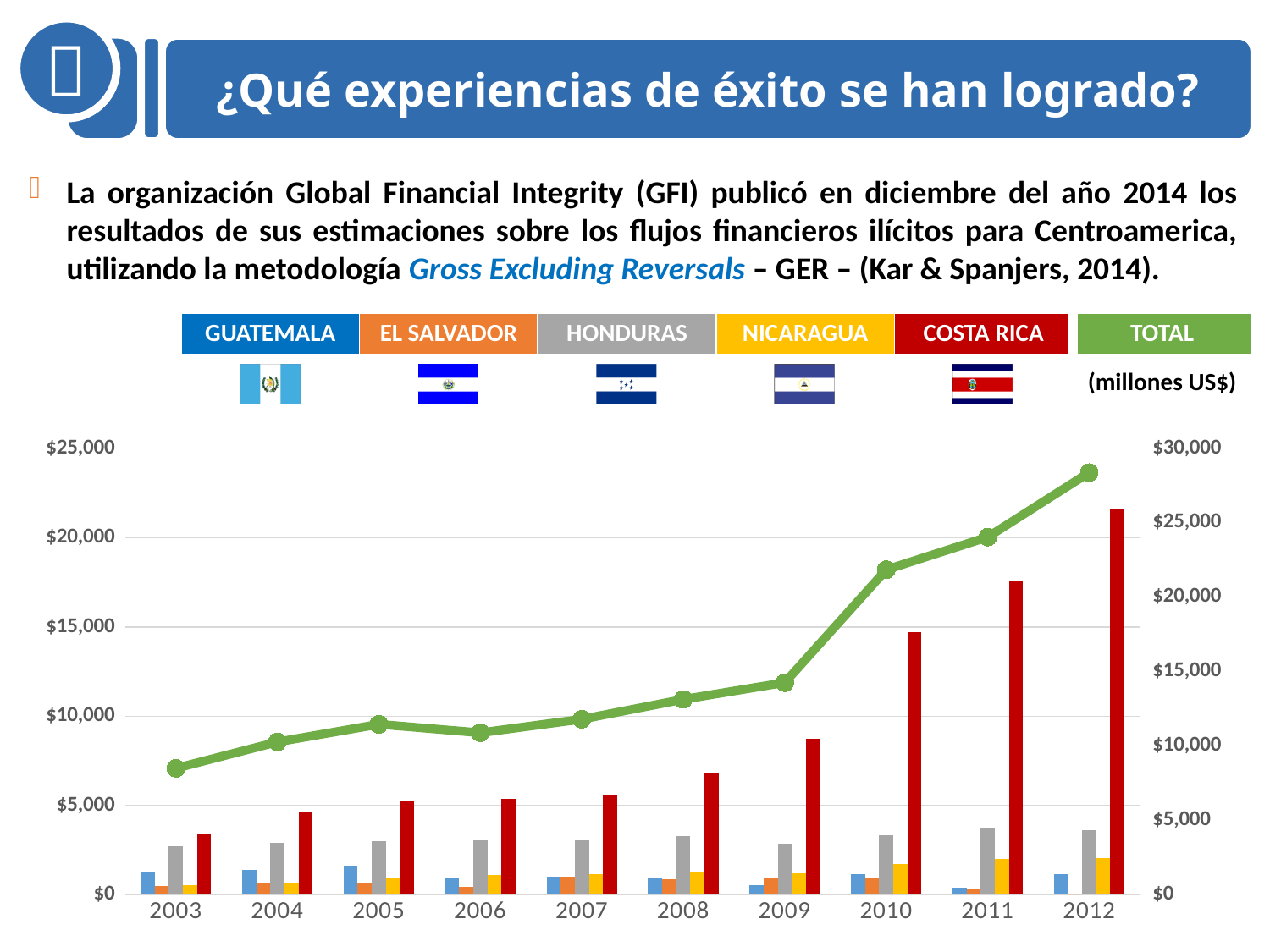
Which country has the highest bar in 2012? COSTA RICA Is the TOTAL value for 2012 greater or less than $25,000 on the right axis? greater In 2011, which is larger: the value for HONDURAS or the value for GUATEMALA? HONDURAS Is the value for COSTA RICA in 2012 greater or less than $20,000 on the left axis? greater How many series does the legend above the chart list? 6 Does the TOTAL line generally rise or fall from 2003 to 2012? Rise What kind of chart is shown on the slide? A combined bar and line chart How many years are shown along the x axis of the chart? 10 Is the value for COSTA RICA in 2011 greater or less than $15,000 on the left axis? greater Which series is plotted as a line rather than bars? TOTAL What colour are the bars for COSTA RICA? Red